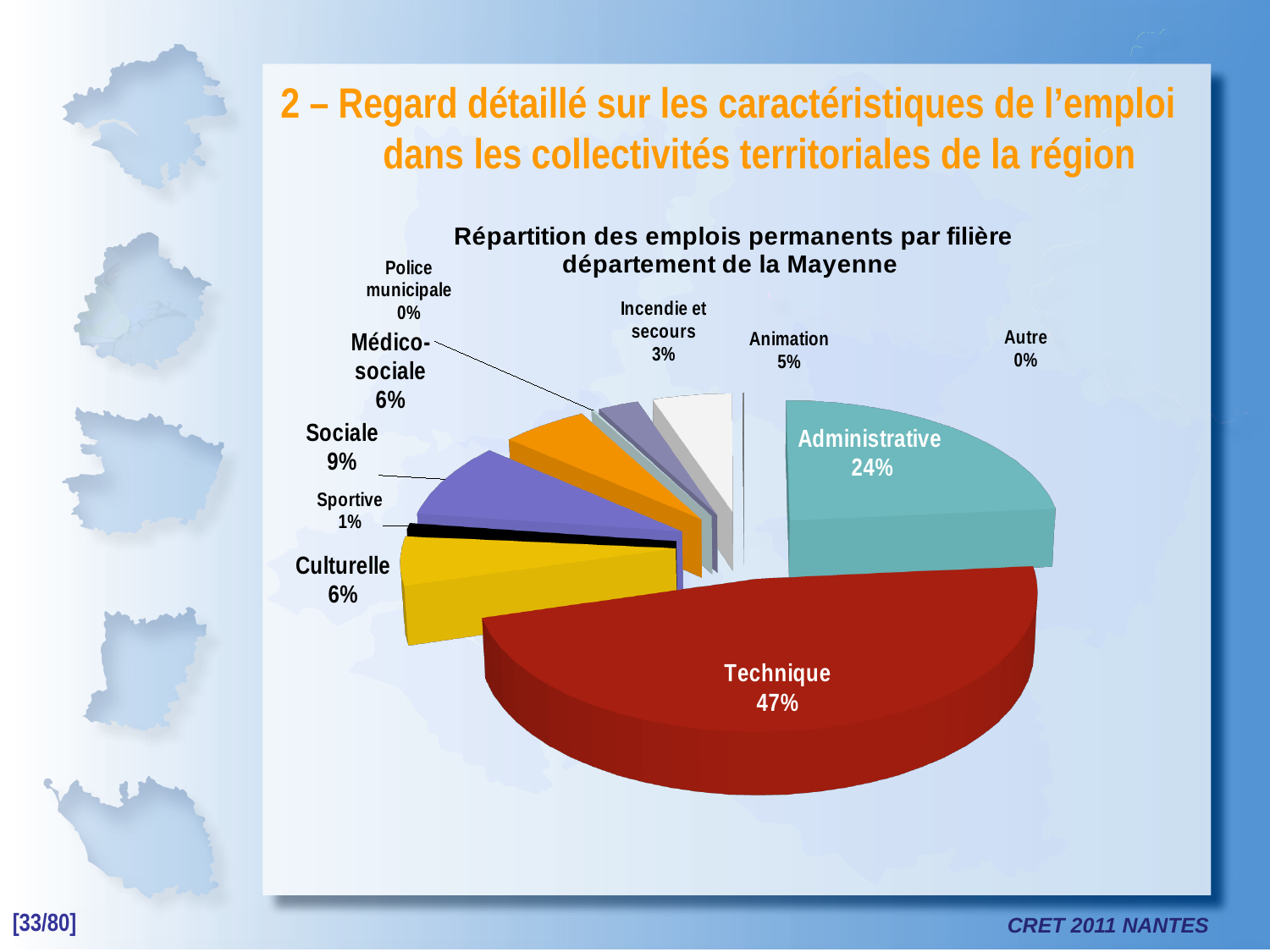
Which département does the chart title say the data is for? Mayenne What share of permanent jobs does the Technique filière hold? 47% What percentage is shown for the Administrative filière? 24% What percentage is shown for Incendie et secours? 3% Which filière has the largest share of permanent jobs? Technique What is the combined share of the Médico-sociale and Culturelle filières? 12% How many filières (slices) are labelled on the pie chart? 10 What is the difference in percentage points between the Technique and Administrative shares? 23 Which has a larger share, Sociale or Animation? Sociale What kind of chart is shown on the slide? Pie chart Which has a larger share, Culturelle or Sportive? Culturelle What percentage is shown for the Sociale filière? 9%